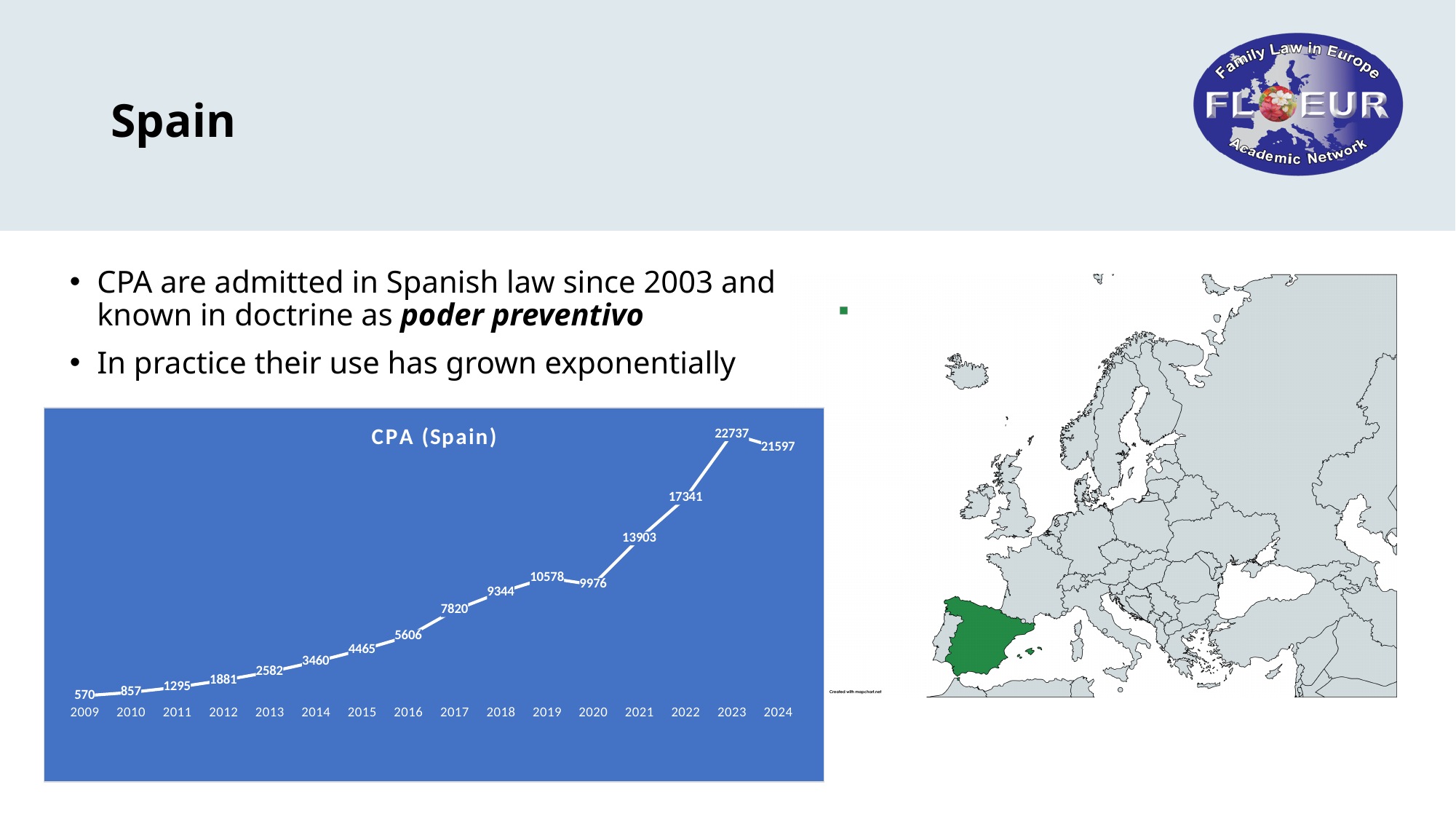
How many years are plotted in the CPA (Spain) chart? 16 Which is larger in the CPA (Spain) chart, the value for 2019 or the value for 2020? 2019 What is the title of the chart on the slide? CPA (Spain) What is the value for 2024 in the CPA (Spain) chart? 21597 What kind of chart is the CPA (Spain) chart? Line chart What is the value for 2016 in the CPA (Spain) chart? 5606 Which year has the highest value in the CPA (Spain) chart? 2023 Which year has the lowest value in the CPA (Spain) chart? 2009 What is the difference between the values for 2022 and 2021 in the CPA (Spain) chart? 3438 What is the difference between the values for 2023 and 2024 in the CPA (Spain) chart? 1140 What is the value for 2009 in the CPA (Spain) chart? 570 What is the value for 2020 in the CPA (Spain) chart? 9976